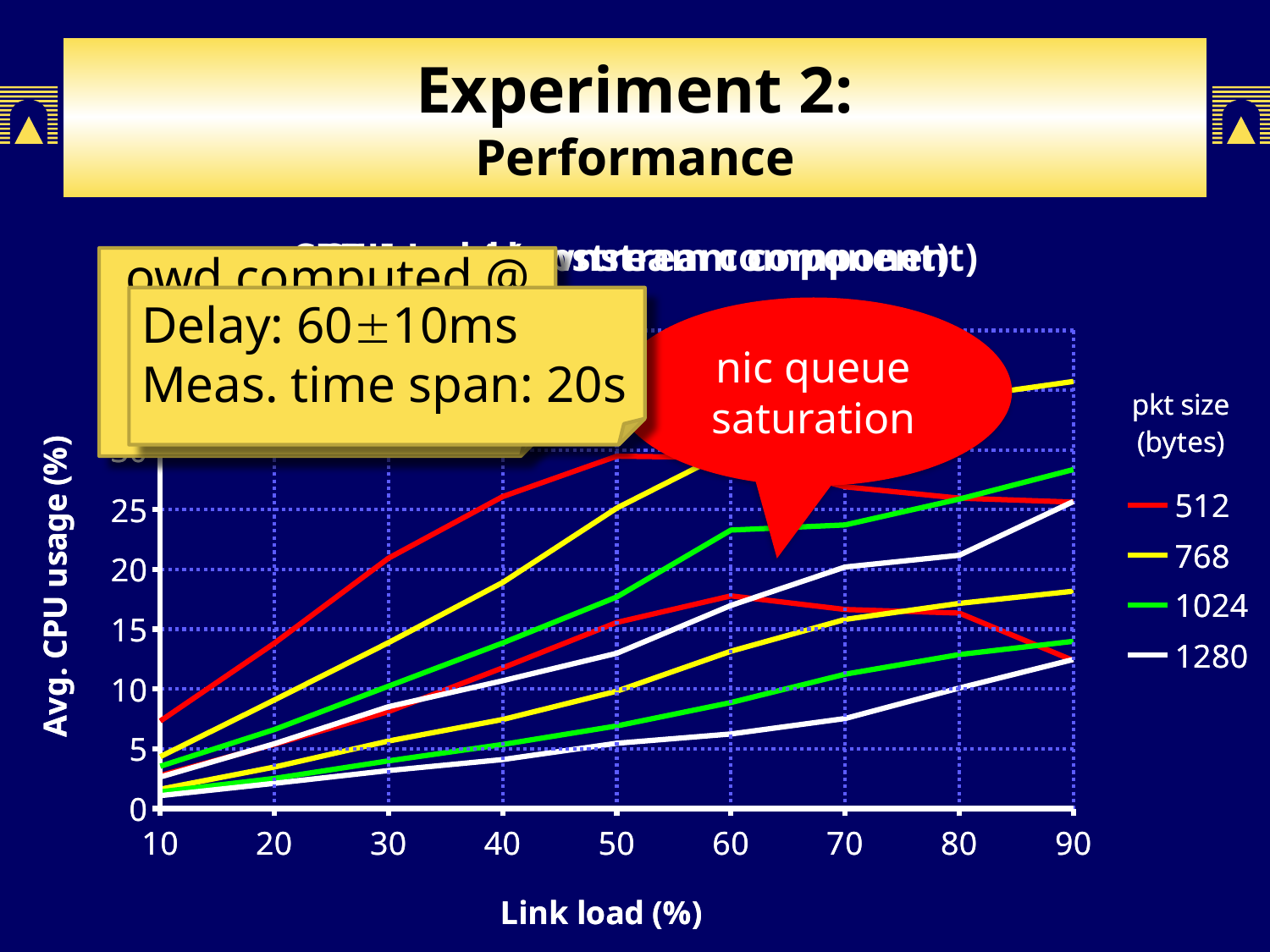
How many packet sizes does the legend list? 4 What kind of chart is shown on the slide? line chart Which packet size is plotted in green? 1024 What is the label of the x axis? Link load (%) What is the label of the y axis? Avg. CPU usage (%) Is the value for packet size 768 at link load 90 greater or less than 15? greater Is the value for packet size 512 at link load 10 greater or less than 10? less Do the values for packet size 768 rise or fall as link load increases? rise Is the value for packet size 1280 at link load 10 greater or less than 5? less How many link load values are marked along the x axis? 9 Which packet size is plotted in red? 512 Do the values for packet size 1280 rise or fall as link load increases? rise